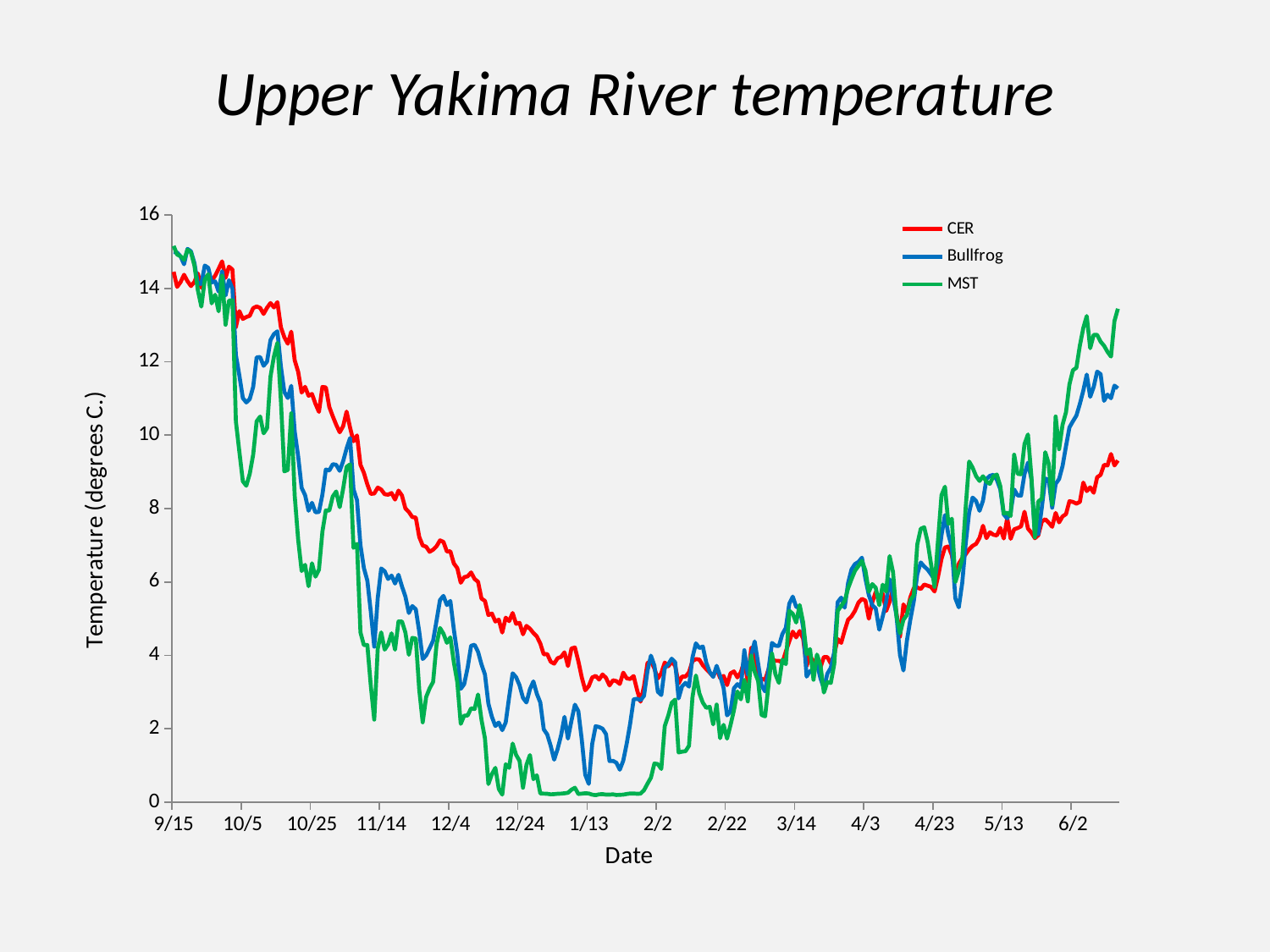
Which series has the lowest values during January? MST What is the label of the vertical axis? Temperature (degrees C.) At the last date plotted, which series has the higher value, CER or MST? MST Is the value for Bullfrog at the last date plotted greater or less than 10? greater At 1/13, which series has the higher value, CER or MST? CER What is the title of the chart? Upper Yakima River temperature Does the CER series rise or fall from 9/15 to 1/13? fall What kind of chart is shown on the slide? line chart Is the value for MST at 1/13 greater or less than 2? less Is the value for MST at the last date plotted greater or less than 12? greater How many series does the legend list? 3